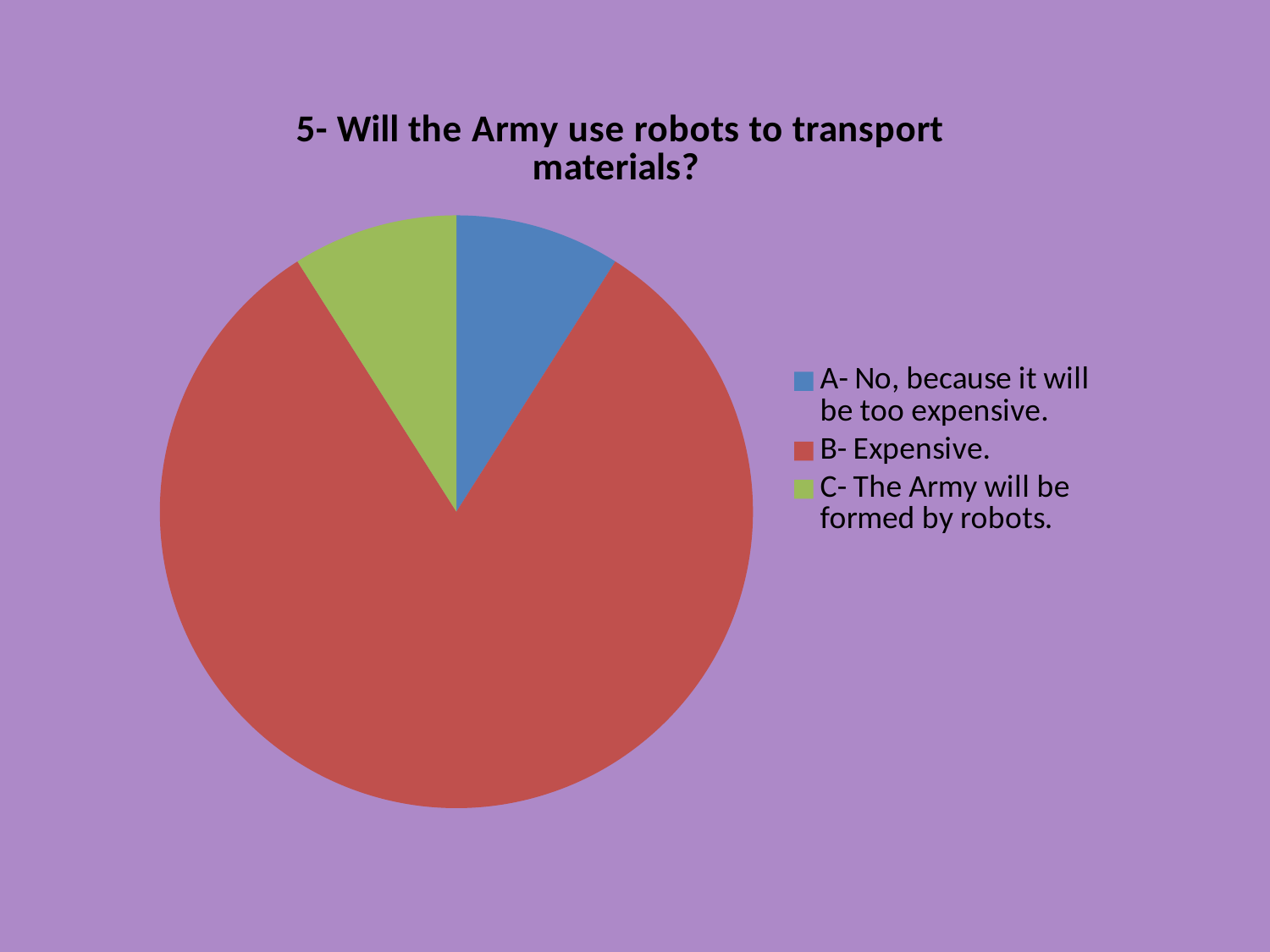
How many entries does the legend list? 3 What is the title of the chart? 5- Will the Army use robots to transport materials? How many slices does the pie chart have? 3 Which slice is larger: "C- The Army will be formed by robots." or "B- Expensive."? B- Expensive. Which slice is larger: "A- No, because it will be too expensive." or "B- Expensive."? B- Expensive. What kind of chart is shown on the slide? pie chart Which answer option has the largest slice of the pie? B- Expensive. Does the slice for "B- Expensive." account for more or less than half of the pie? more What colour is the slice for "B- Expensive."? red